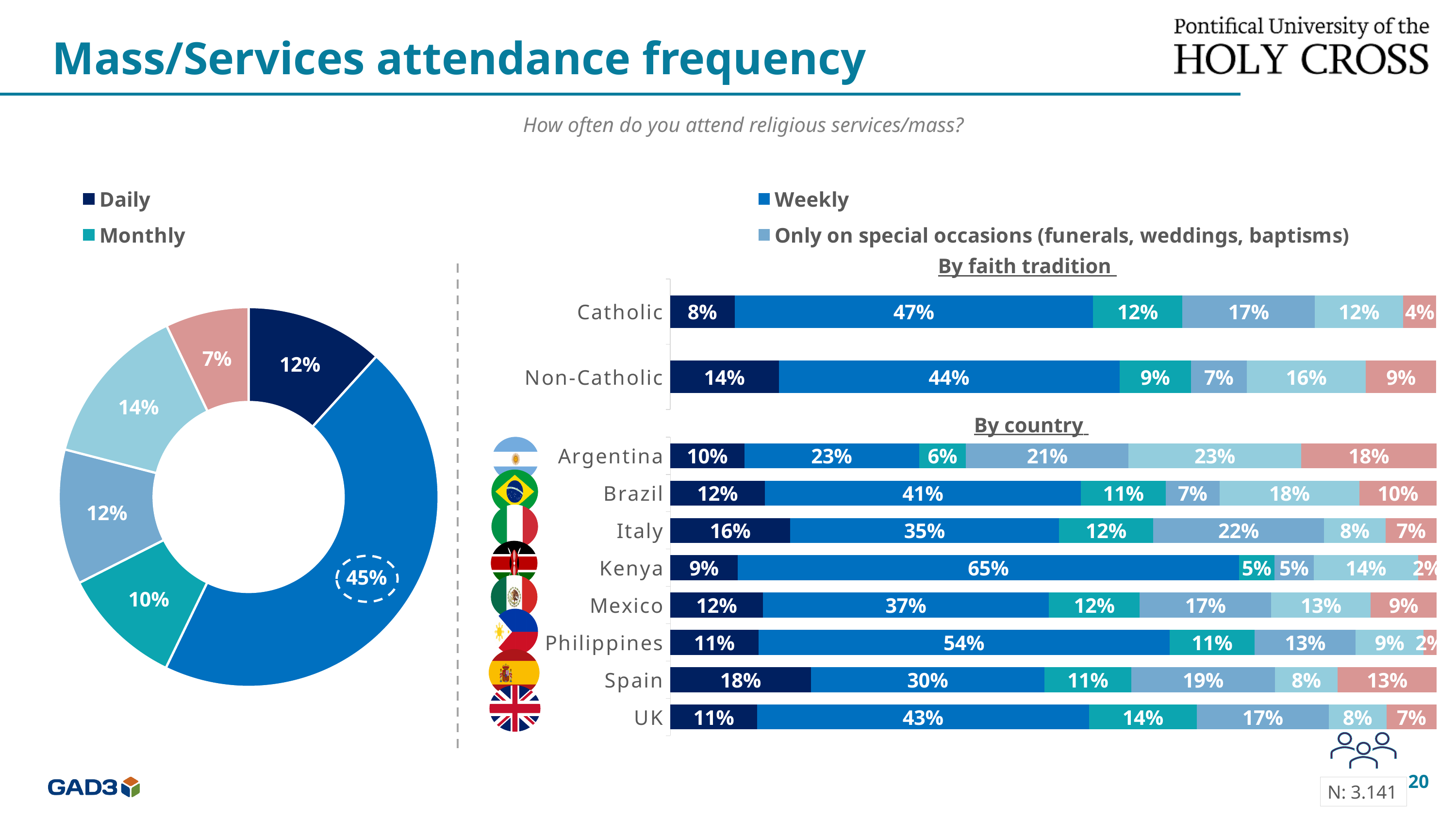
In the 'By faith tradition' bar chart, what is the difference between the Weekly values for Catholic and Non-Catholic? 3% How many countries are shown in the 'By country' bar chart? 8 In the 'By country' bar chart, which country has the highest Daily value? Spain In the 'By faith tradition' bar chart, which group has the larger Daily value, Catholic or Non-Catholic? Non-Catholic In the donut chart on the left, what share of respondents attend weekly? 45% In the 'By country' bar chart, what is the 'Only on special occasions' value for Italy? 22% In the 'By country' bar chart, which country has the highest Weekly value? Kenya What type of chart is used for the 'By country' breakdown? Stacked bar chart In the donut chart on the left, what share of respondents attend monthly? 10% In the donut chart on the left, what share of respondents attend daily? 12% In the 'By country' bar chart, what is the Weekly value for the Philippines? 54% In the 'By country' bar chart, which country has the lowest Weekly value? Argentina